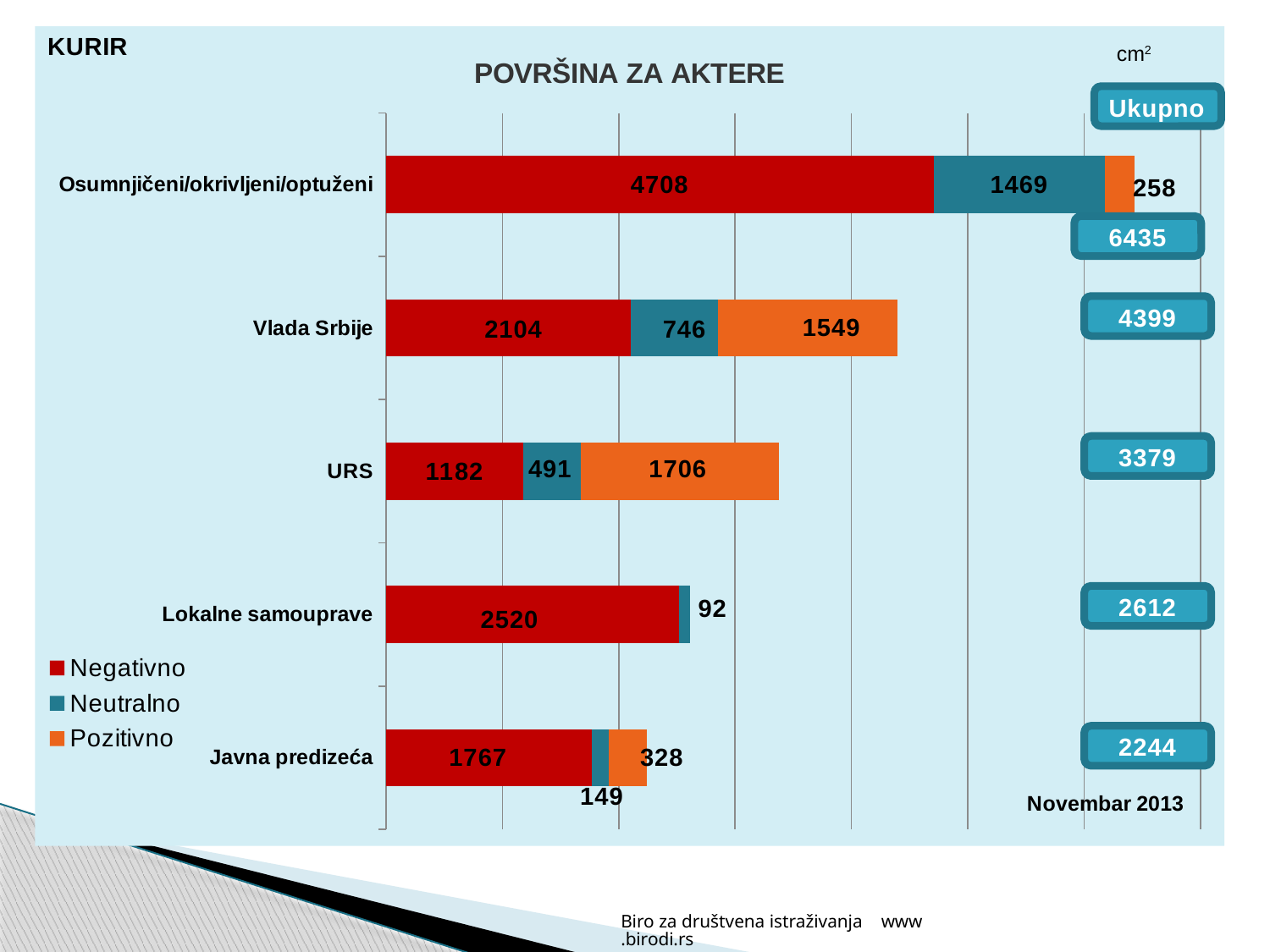
How many categories are shown on the chart? 5 What is the total of the stacked bar for Vlada Srbije? 4399 What is the Neutralno value for Osumnjičeni/okrivljeni/optuženi? 1469 What kind of chart is shown on the slide? Stacked bar chart What is the Ukupno (total) value shown for Javna predizeća? 2244 Which is larger, the Pozitivno value for Vlada Srbije or the Pozitivno value for URS? URS Which category has the lowest Ukupno total? Javna predizeća What is the difference between the Negativno values for Lokalne samouprave and Javna predizeća? 753 Which category has the highest Negativno value? Osumnjičeni/okrivljeni/optuženi What is the Negativno value for Vlada Srbije? 2104 What is the Pozitivno value for URS? 1706 How many series does the legend list? 3